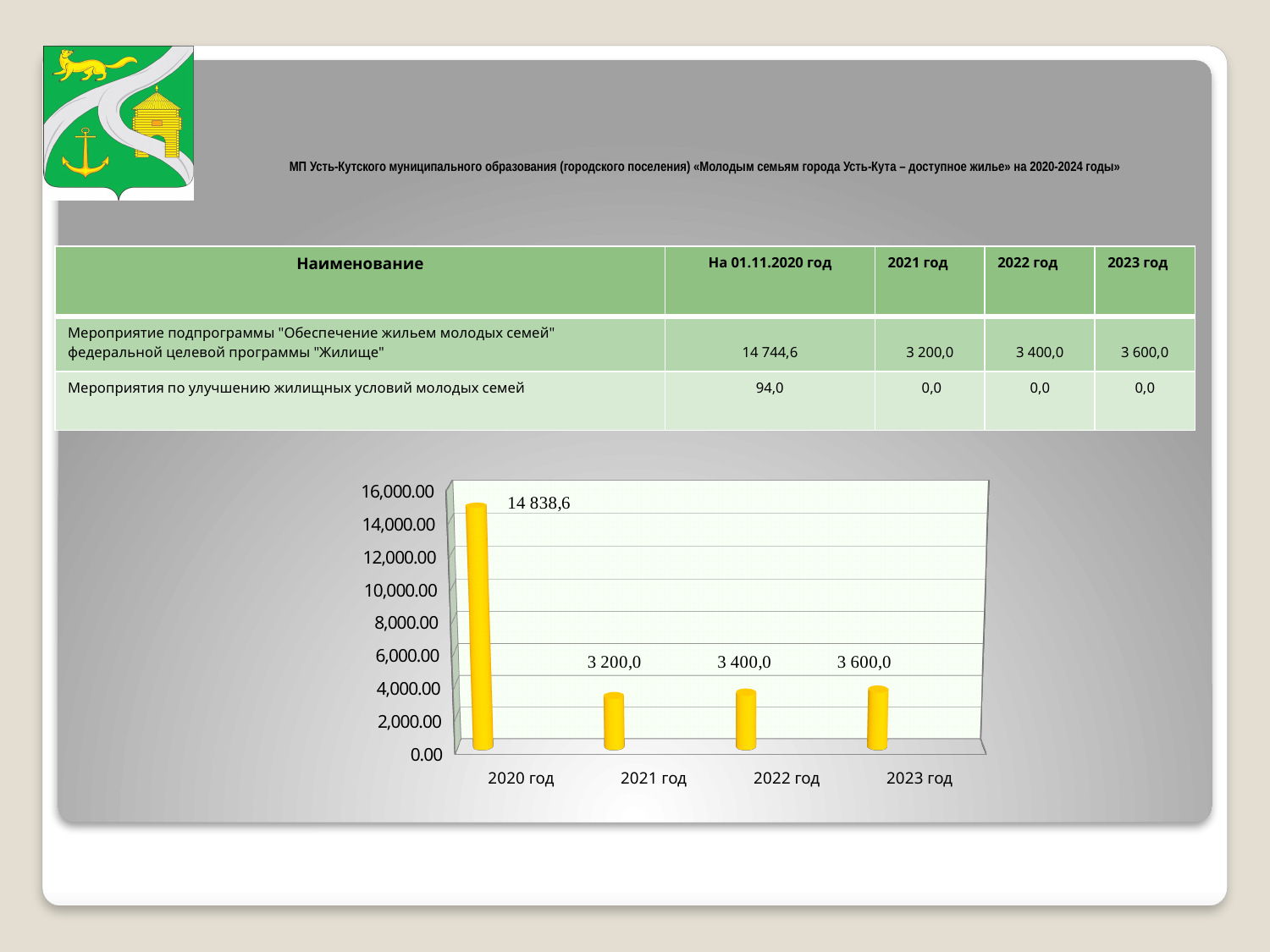
Which year has the highest value in the chart? 2020 год What is the value shown for 2022 год in the chart? 3 400,0 What is the value shown for 2020 год in the chart? 14 838,6 What is the value shown for 2021 год in the chart? 3 200,0 What kind of chart is shown on the slide? bar chart What is the difference between the values for 2023 год and 2021 год in the chart? 400,0 Which is larger in the chart, the value for 2022 год or the value for 2023 год? 2023 год How many years (categories) are shown on the x axis of the chart? 4 What is the value shown for 2023 год in the chart? 3 600,0 Which year has the lowest value in the chart? 2021 год Is the value for 2020 год in the chart greater or less than 14,000.00? greater Do the values rise or fall from 2021 год to 2023 год in the chart? rise